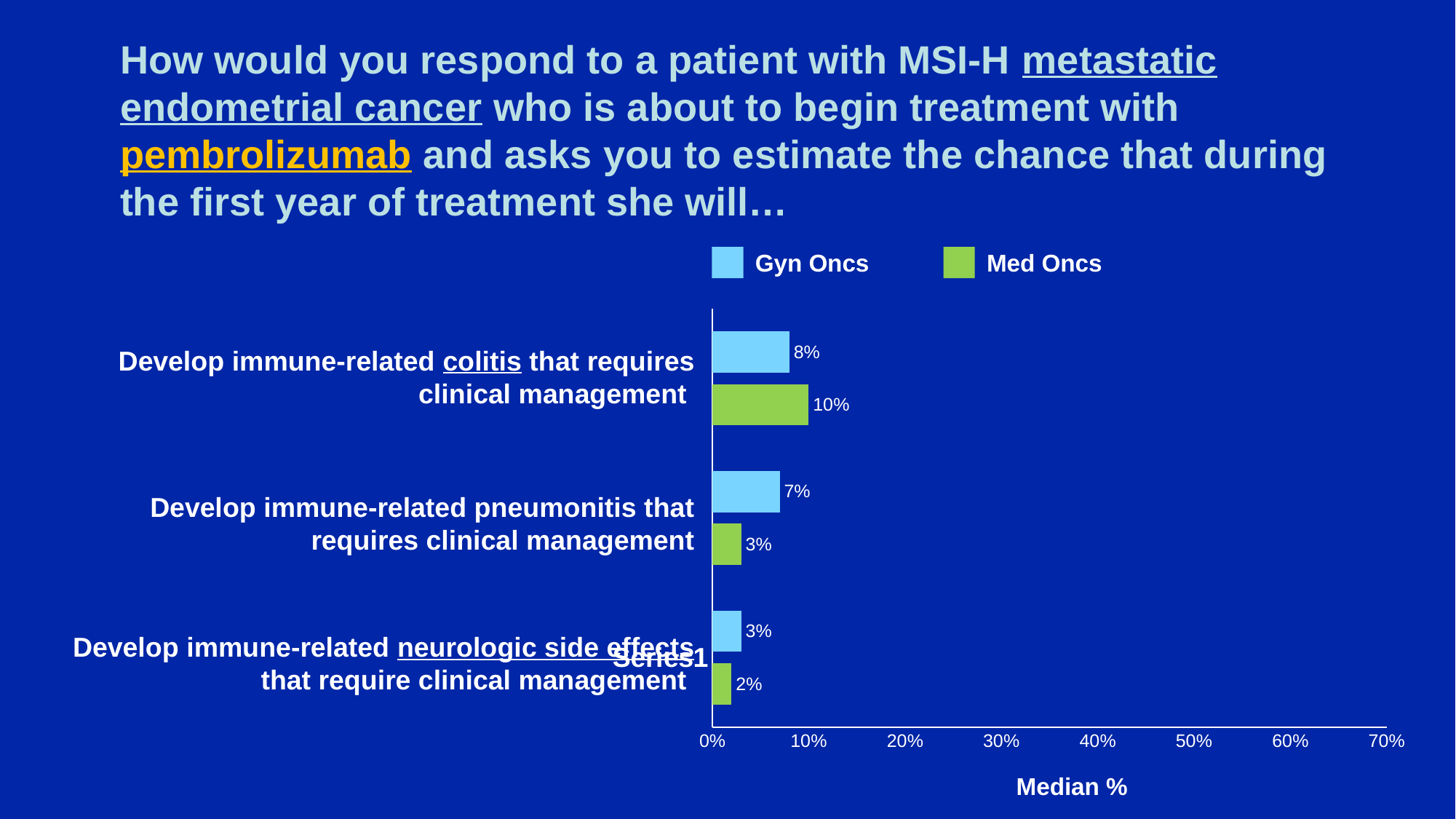
Is the Med Oncs value for immune-related colitis greater or less than 20%? less What is the Gyn Oncs value for developing immune-related pneumonitis that requires clinical management? 7% What is the Med Oncs value for developing immune-related neurologic side effects that require clinical management? 2% Which category has the highest Med Oncs value? Develop immune-related colitis that requires clinical management What is the Med Oncs value for developing immune-related colitis that requires clinical management? 10% How many categories are shown on the chart? 3 What is the difference between the Gyn Oncs and Med Oncs values for immune-related pneumonitis? 4% What kind of chart is shown on the slide? Bar chart What is the Gyn Oncs value for developing immune-related colitis that requires clinical management? 8% For immune-related colitis, which group gives the larger value, Gyn Oncs or Med Oncs? Med Oncs Which category has the lowest Gyn Oncs value? Develop immune-related neurologic side effects that require clinical management How many series does the legend list? 2